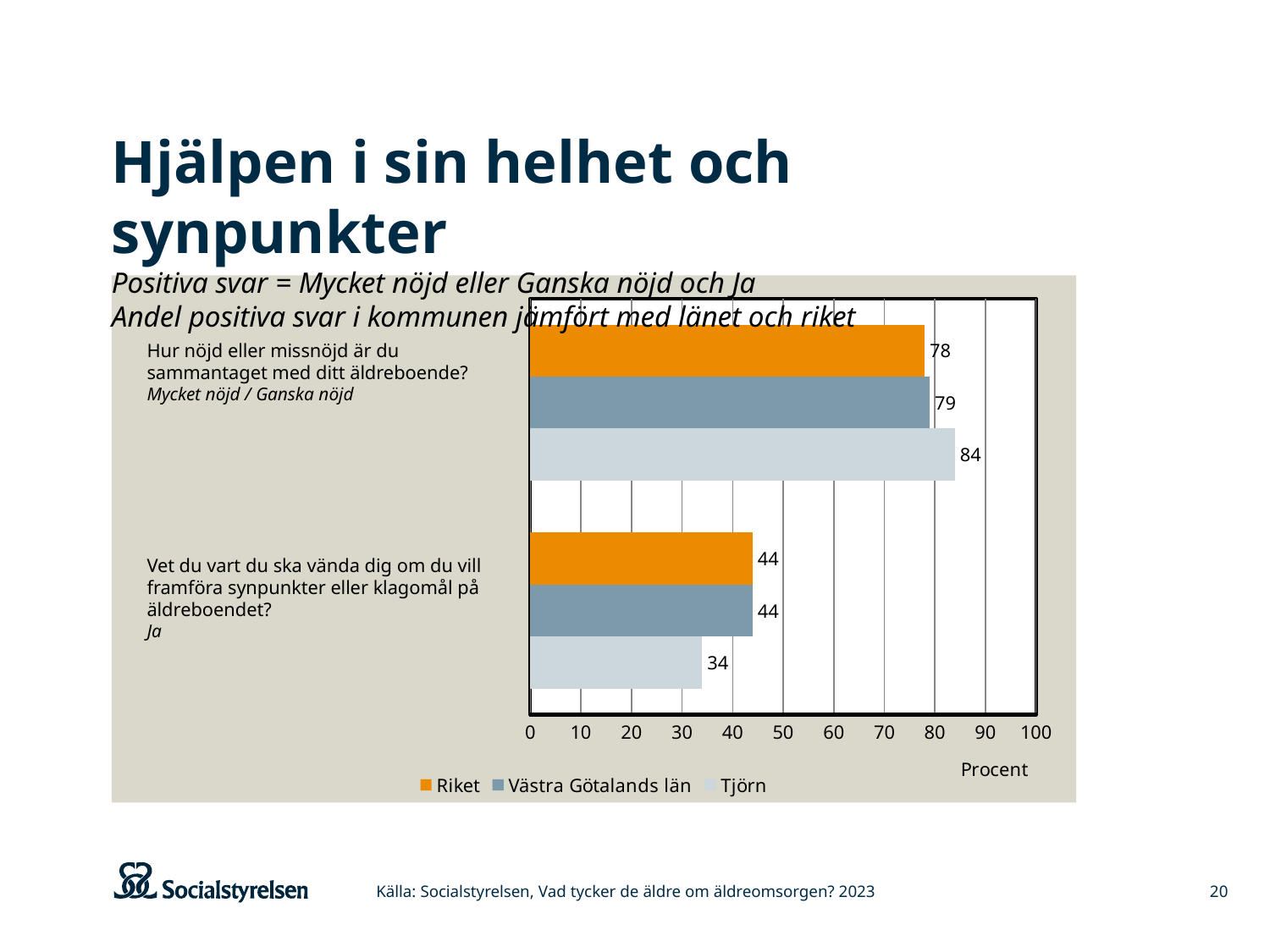
What is the value for Västra Götalands län on the question "Hur nöjd eller missnöjd är du sammantaget med ditt äldreboende?"? 79 What is the difference between Tjörn and Riket on the question "Hur nöjd eller missnöjd är du sammantaget med ditt äldreboende?"? 6 Is the value for Tjörn on the question about knowing where to turn with complaints greater or less than 40? less What kind of chart is shown on the slide? Bar chart How many series does the legend list? 3 Which series has the lowest value on the question "Vet du vart du ska vända dig om du vill framföra synpunkter eller klagomål på äldreboendet?"? Tjörn What is the value for Tjörn on the question "Hur nöjd eller missnöjd är du sammantaget med ditt äldreboende?"? 84 What is the value for Tjörn on the question "Vet du vart du ska vända dig om du vill framföra synpunkter eller klagomål på äldreboendet?"? 34 What is the value for Riket on the question "Vet du vart du ska vända dig om du vill framföra synpunkter eller klagomål på äldreboendet?"? 44 What is the difference between Riket and Tjörn on the question "Vet du vart du ska vända dig om du vill framföra synpunkter eller klagomål på äldreboendet?"? 10 What unit is shown on the x axis of the chart? Procent Which series has the highest value on the question "Hur nöjd eller missnöjd är du sammantaget med ditt äldreboende?"? Tjörn